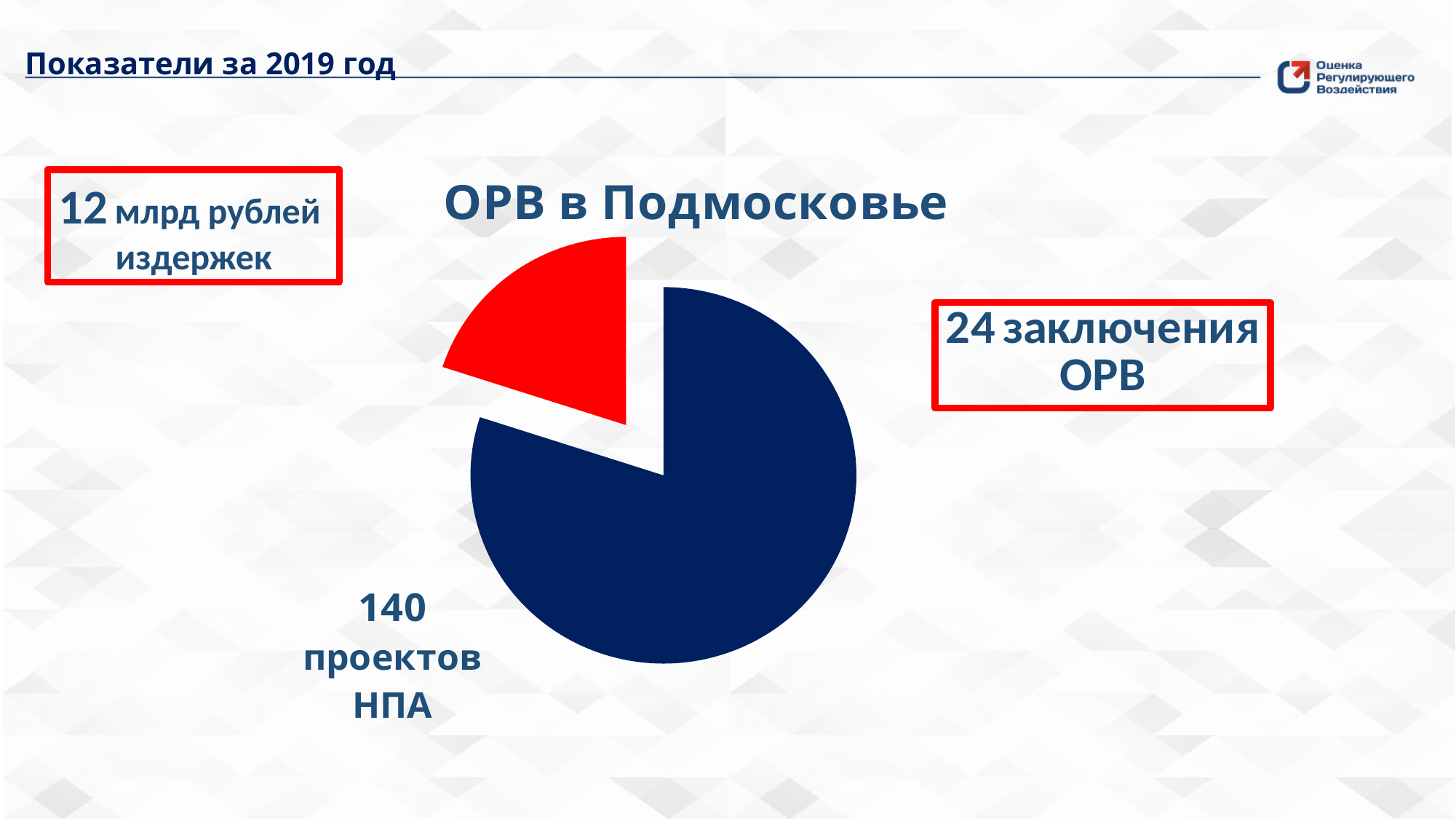
What is the title of the pie chart? ОРВ в Подмосковье How many slices does the pie chart have? 2 Which slice of the pie chart is the largest? the dark blue slice What kind of chart is shown on the slide? pie chart Is the value for проекты НПА greater or less than 100? greater Which is larger in the pie chart: проекты НПА or заключения ОРВ? проекты НПА Which slice of the pie chart is the smallest? the red slice